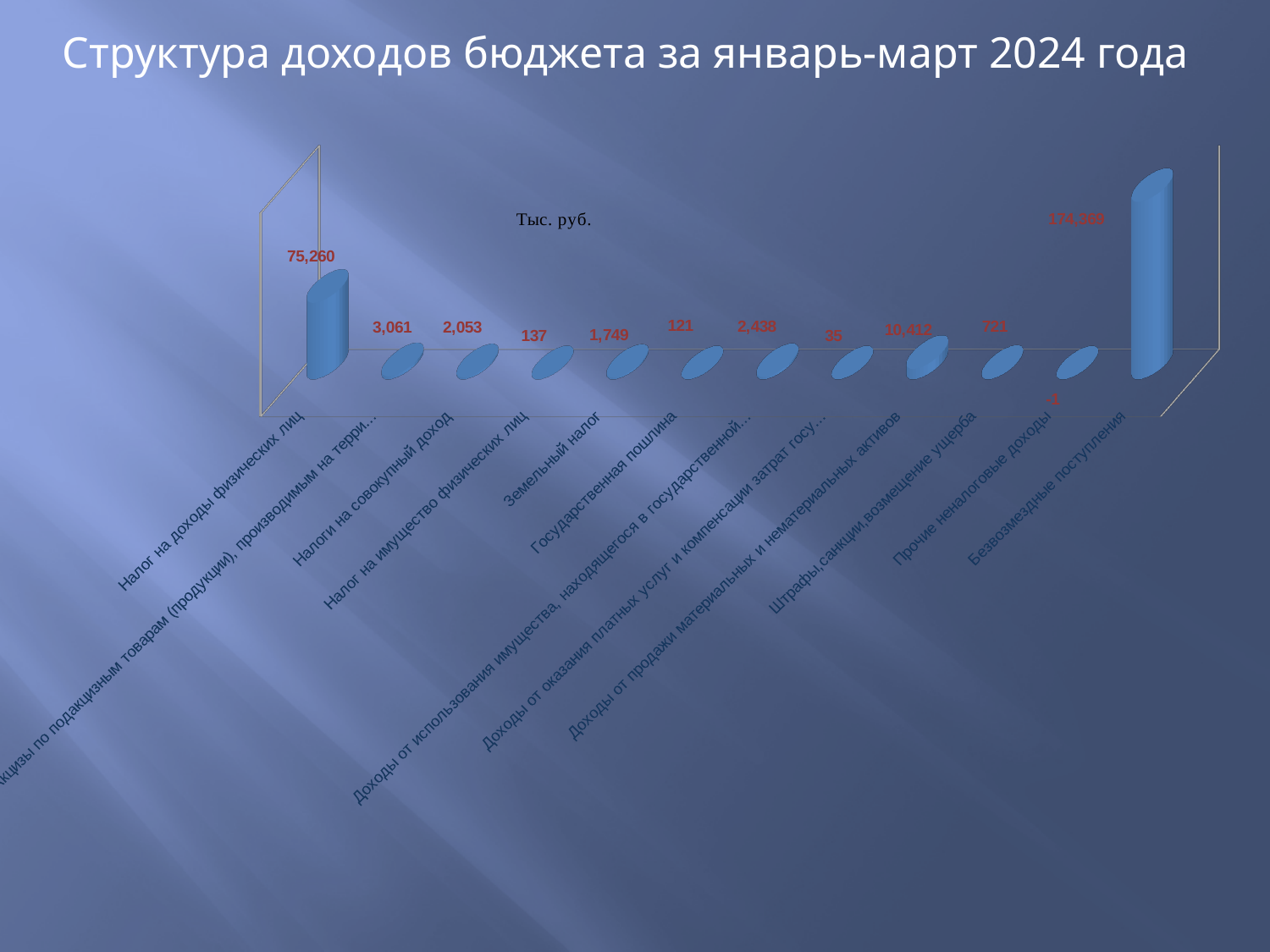
What unit label is shown on the chart? Тыс. руб. What is the value for Земельный налог? 1,749 Which category has the highest value? Безвозмездные поступления What is the difference between the values for Налог на доходы физических лиц and Доходы от продажи материальных и нематериальных активов? 64,848 What is the value for Государственная пошлина? 121 Which is larger: Налоги на совокупный доход or Доходы от использования имущества, находящегося в государственной...? Доходы от использования имущества, находящегося в государственной... What is the value for Налог на доходы физических лиц? 75,260 What is the value for Доходы от продажи материальных и нематериальных активов? 10,412 Which category has the lowest value? Прочие неналоговые доходы What is the value for Штрафы, санкции, возмещение ущерба? 721 How many categories are shown in the chart? 12 What is the value for Налог на имущество физических лиц? 137